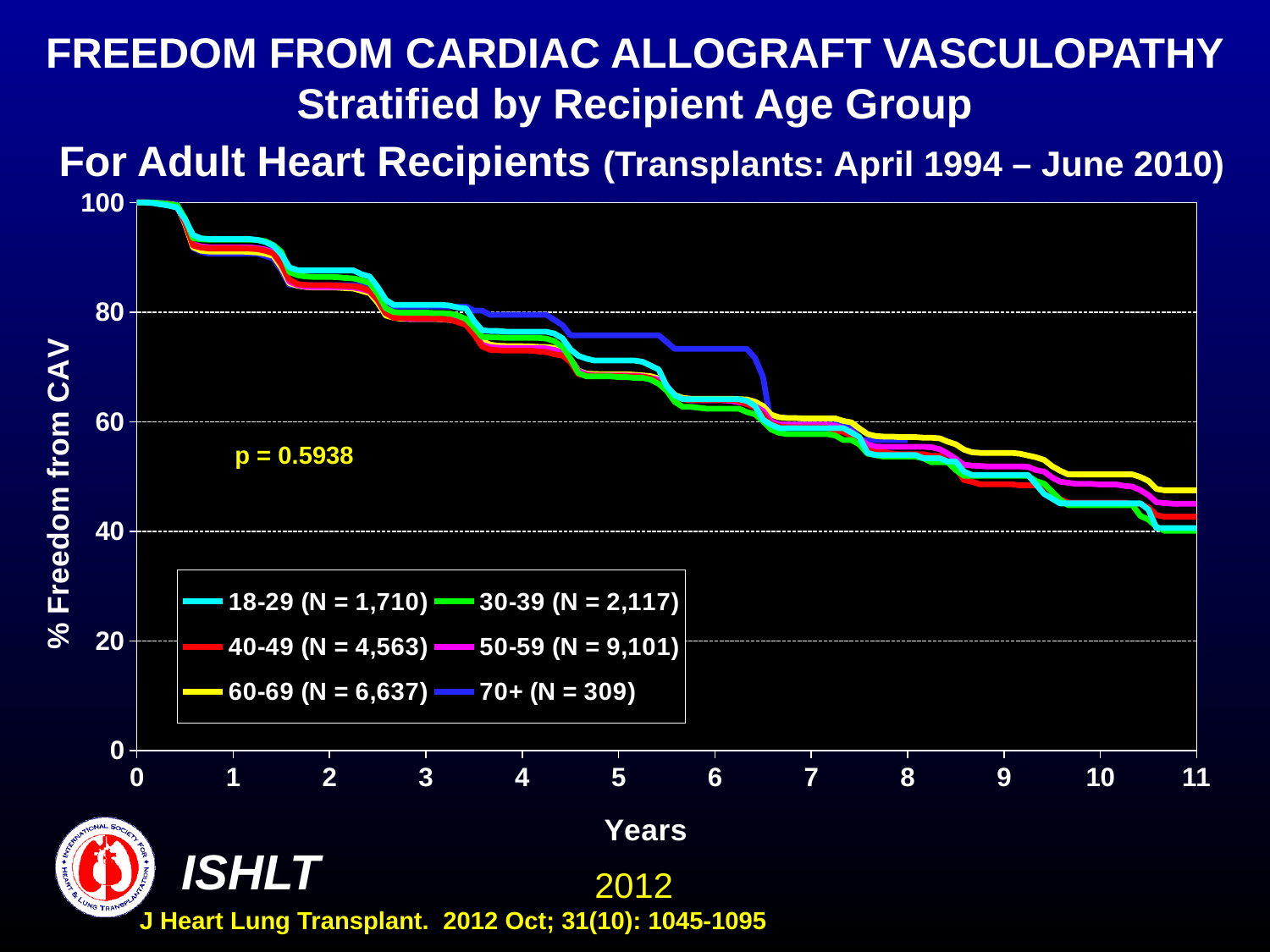
Do the curves rise or fall as the number of years increases? fall How many recipient age groups does the legend list? 6 Is the value for the 60-69 group at 11 years greater or less than 40? greater What is the N value shown in the legend for the 50-59 age group? 9,101 Which age group has the smallest N according to the legend? 70+ What is the N value shown in the legend for the 70+ age group? 309 Which age group has the largest N according to the legend? 50-59 What is the label of the y axis? % Freedom from CAV Which age group's curve is highest at around 6 years? 70+ What kind of chart is shown on the slide? line chart What p-value is printed on the chart? p = 0.5938 Is the value for the 70+ group at 6 years greater or less than 60? greater